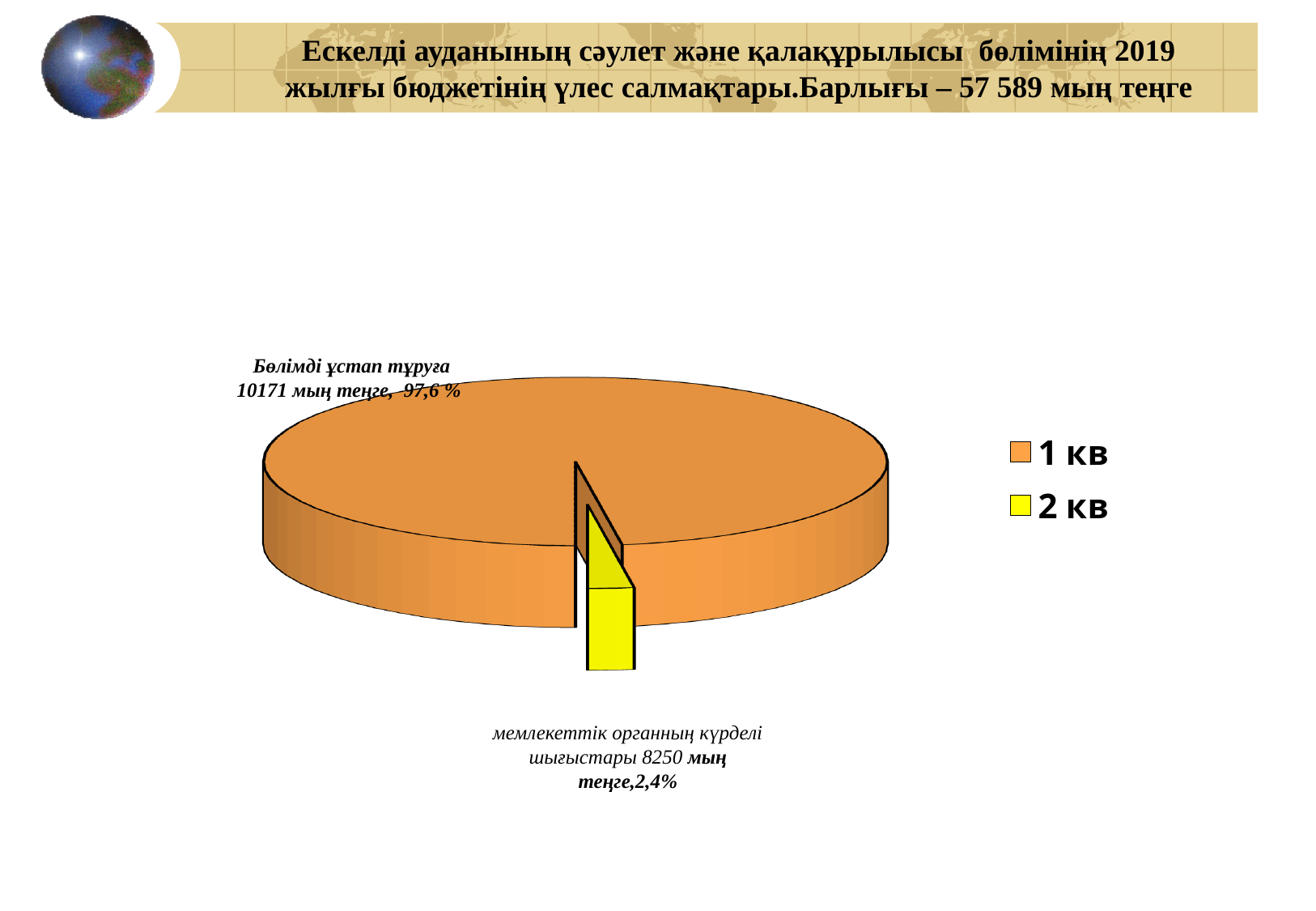
What amount in мың теңге is shown for "Бөлімді ұстап тұруға"? 10171 мың теңге What percentage share is shown for "мемлекеттік органның күрделі шығыстары"? 2,4% How many slices does the pie chart have? 2 What amount in мың теңге is shown for "мемлекеттік органның күрделі шығыстары"? 8250 мың теңге Which slice of the pie chart is the largest? 1 кв Which slice of the pie chart is the smallest? 2 кв What percentage share is shown for "Бөлімді ұстап тұруға"? 97,6 % How many entries does the legend of the pie chart list? 2 Which slice is larger, "1 кв" or "2 кв"? 1 кв What colour is the "2 кв" slice in the pie chart? yellow What kind of chart is shown on the slide? pie chart What total amount is stated in the slide title? 57 589 мың теңге